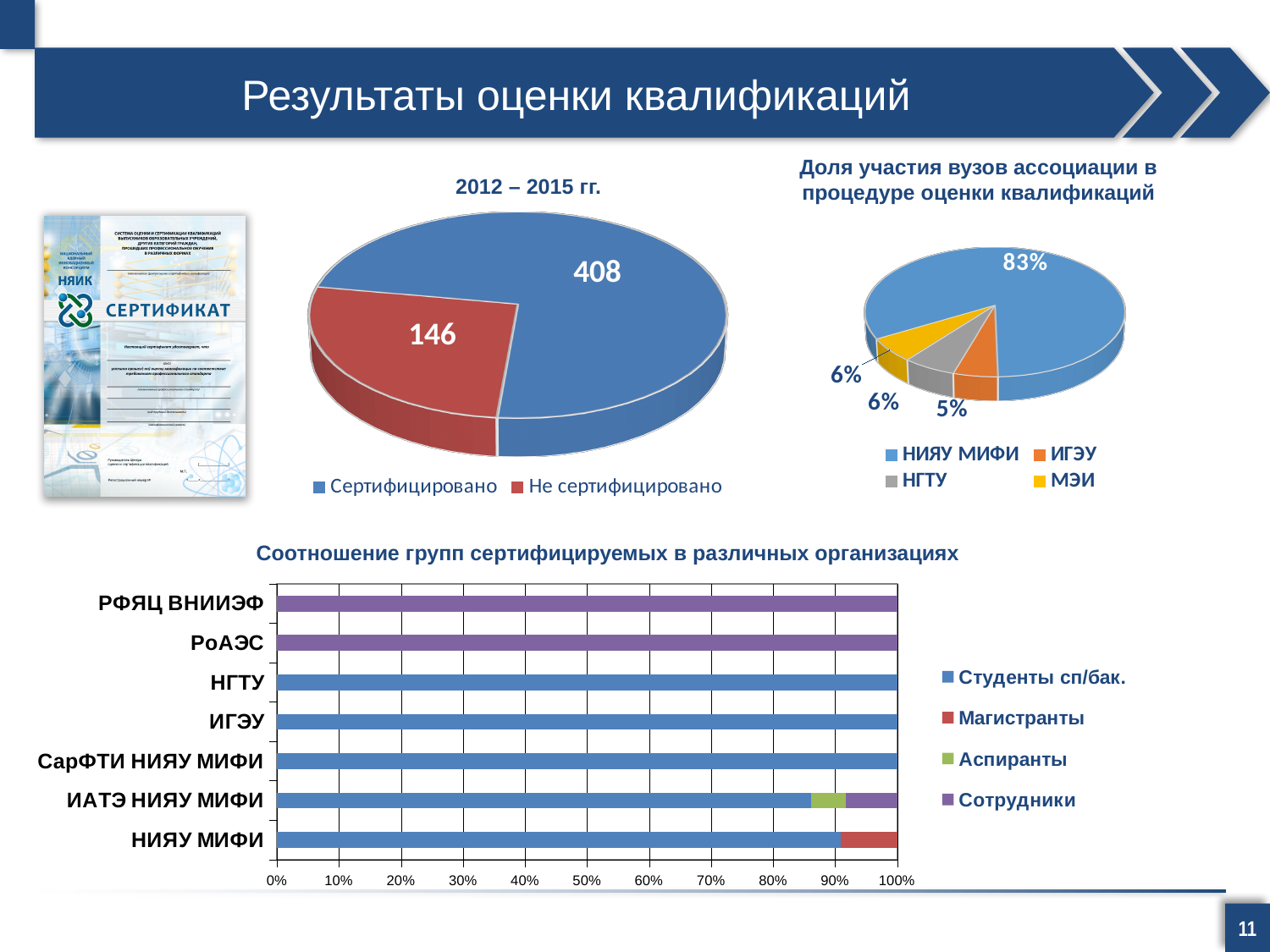
In the pie chart titled "2012 – 2015 гг.", what is the value for "Не сертифицировано"? 146 How many organisations are listed on the vertical axis of the chart titled "Соотношение групп сертифицируемых в различных организациях"? 7 In the pie chart titled "Доля участия вузов ассоциации в процедуре оценки квалификаций", what share does НИЯУ МИФИ have? 83% In the chart titled "Соотношение групп сертифицируемых в различных организациях", is the share of "Студенты сп/бак." for НИЯУ МИФИ greater or less than 80%? greater In the pie chart titled "Доля участия вузов ассоциации в процедуре оценки квалификаций", which university has the smallest share? ИГЭУ In the pie chart titled "Доля участия вузов ассоциации в процедуре оценки квалификаций", which university has the largest share? НИЯУ МИФИ In the pie chart titled "Доля участия вузов ассоциации в процедуре оценки квалификаций", what share does ИГЭУ have? 5% What kind of chart is the chart titled "Соотношение групп сертифицируемых в различных организациях"? Bar chart In the pie chart titled "2012 – 2015 гг.", what is the value for "Сертифицировано"? 408 In the pie chart titled "2012 – 2015 гг.", what is the total of the two slices? 554 In the pie chart titled "2012 – 2015 гг.", what is the difference between the "Сертифицировано" and "Не сертифицировано" values? 262 How many entries does the legend of the pie chart titled "Доля участия вузов ассоциации в процедуре оценки квалификаций" list? 4